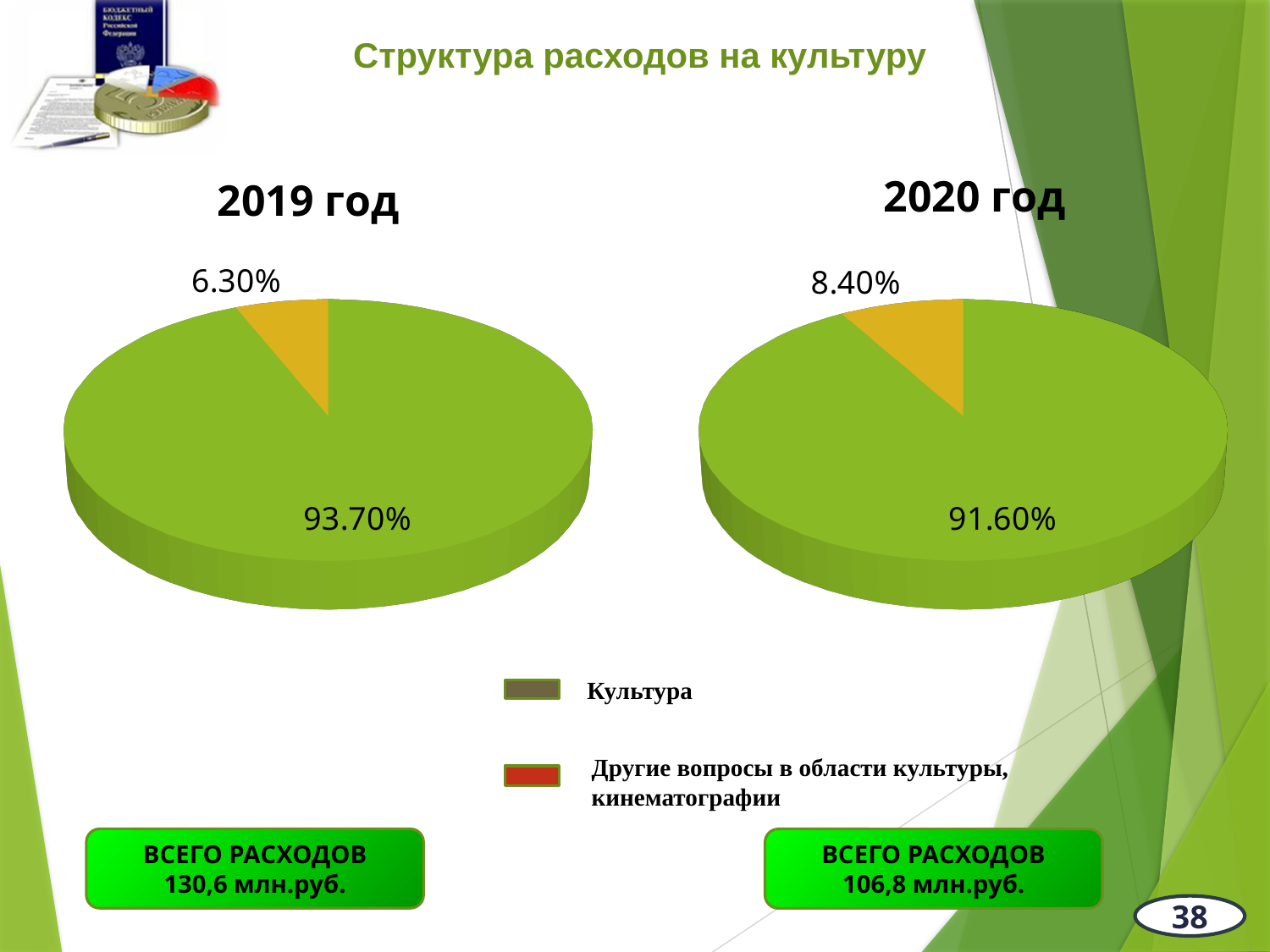
What is the title at the top of the slide above the two pie charts? Структура расходов на культуру How many slices does the 2020 год pie chart have? 2 What kind of chart is used for the 2019 год chart? pie chart How many entries does the shared legend list? 2 In the 2020 год chart, what is the value of the largest slice? 91.60% In the 2020 год chart, what is the value of the smaller slice? 8.40% In the 2020 год chart, what is the difference between the two slice values? 83.20% In the 2019 год chart, what is the value of the smaller slice? 6.30% In the 2019 год chart, what is the difference between the two slice values? 87.40% Which chart has the larger small slice, 2019 год or 2020 год? 2020 год In the 2019 год chart, what is the value of the largest slice? 93.70% What is the first entry in the legend below the charts? Культура